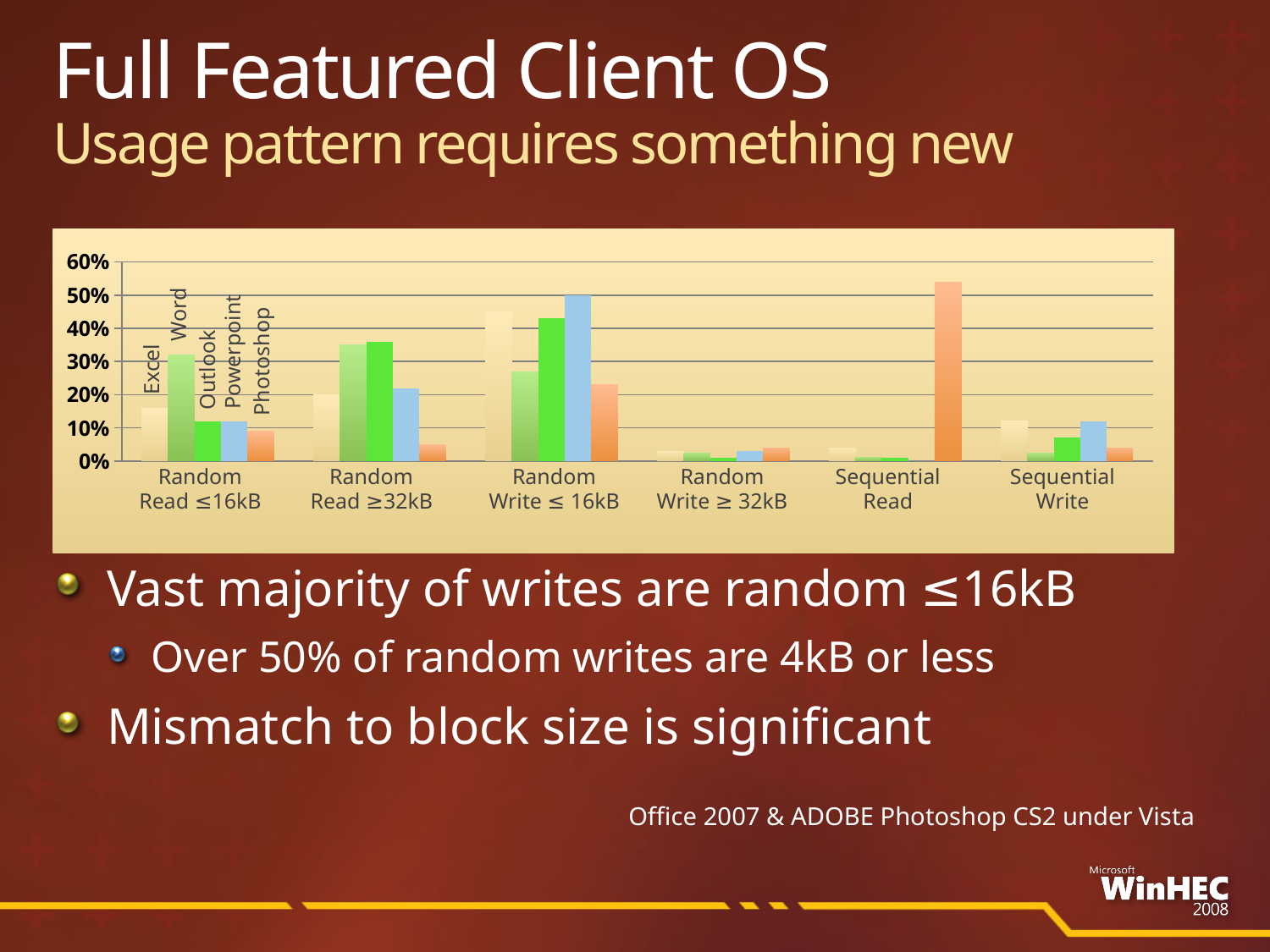
Which application has the tallest bar in the Sequential Read category? Photoshop Which is larger in the Random Write ≤ 16kB category: the Word bar or the Powerpoint bar? Powerpoint Which is larger in the Random Read ≤16kB category: the Excel bar or the Word bar? Word Which application has the lowest bar in the Random Read ≥32kB category? Photoshop What kind of chart is shown on the slide? bar chart How many series (applications) does the chart plot? 5 Is the Photoshop value for Sequential Read greater or less than 50%? greater How many categories are shown along the x axis of the chart? 6 Is the Photoshop value for Random Read ≥32kB greater or less than 10%? less Which applications are labelled as the series in the chart? Excel, Word, Outlook, Powerpoint, Photoshop Is the Excel value for Random Write ≤ 16kB greater or less than 40%? greater